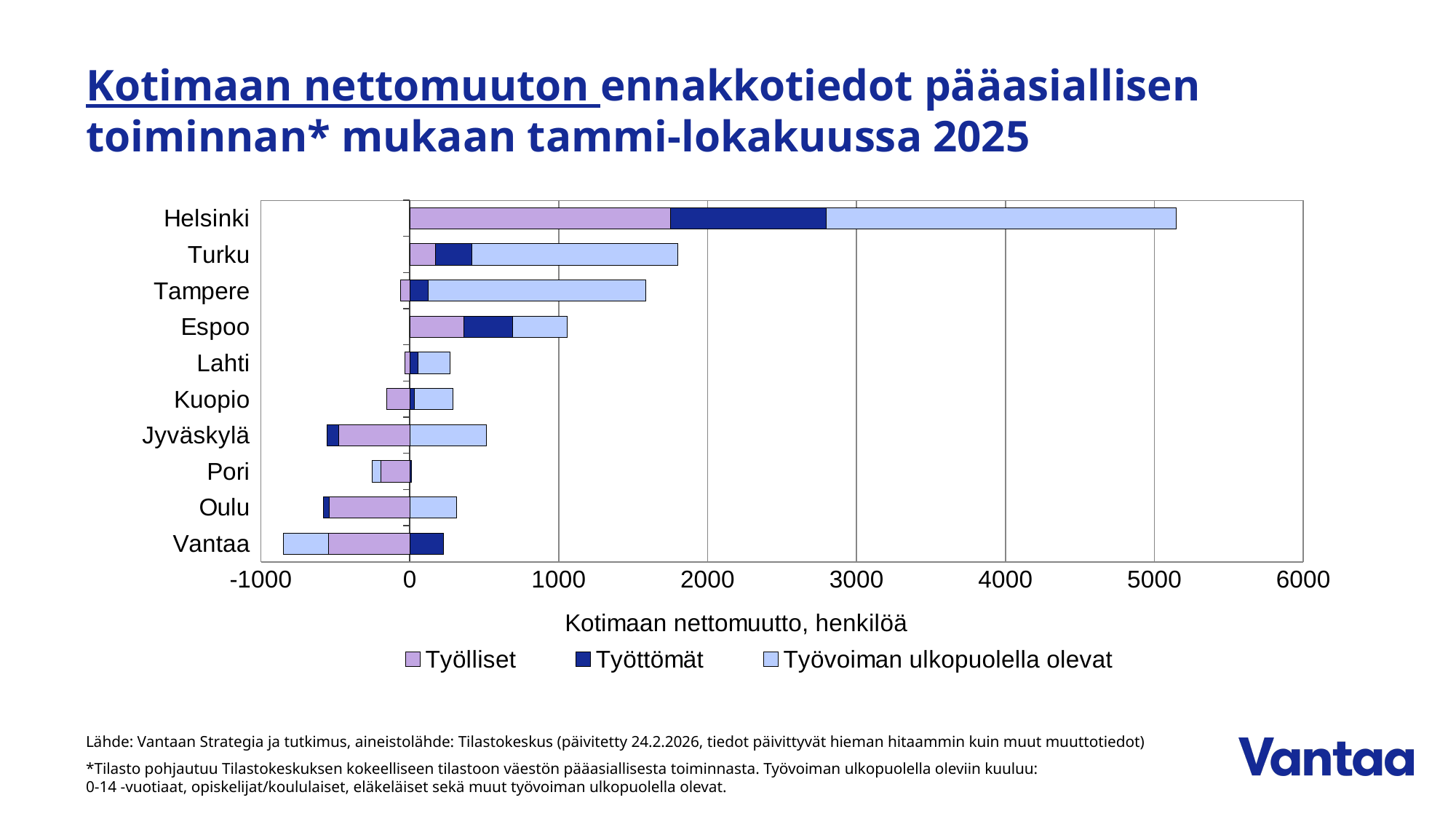
Is the Työlliset value for Vantaa greater or less than 0? less Is the Työlliset value for Helsinki greater or less than 1000? greater Which legend entry is shown in the darkest blue colour? Työttömät What kind of chart is shown on the slide? Stacked bar chart Is the total bar for Turku greater or less than 1000? greater Which city has the longest bar (largest positive net migration) in the chart? Helsinki What is the title of the horizontal axis of the chart? Kotimaan nettomuutto, henkilöä Which city has the larger total bar, Turku or Tampere? Turku How many cities are listed on the vertical axis of the chart? 10 How many series does the legend list? 3 Which city has the larger total bar, Helsinki or Espoo? Helsinki